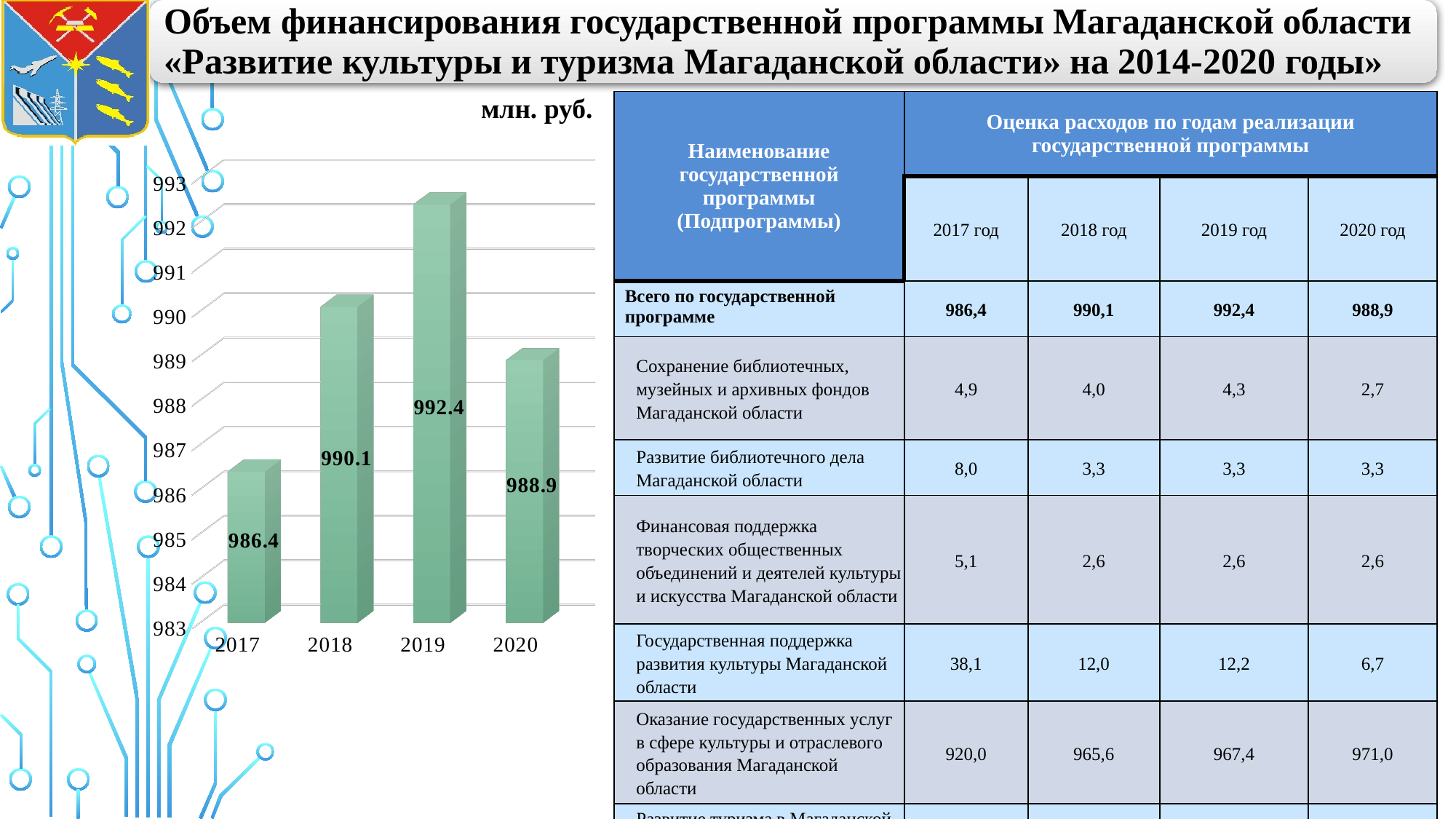
What is the value for 2020 in the bar chart? 988.9 Which is larger in the bar chart, the value for 2018 or the value for 2020? 2018 What unit is indicated above the bar chart? млн. руб. Which year has the lowest value in the bar chart? 2017 Which year has the highest value in the bar chart? 2019 How many years are shown in the bar chart? 4 What is the value for 2019 in the bar chart? 992.4 What is the value for 2017 in the bar chart? 986.4 What is the difference between the values for 2019 and 2017 in the bar chart? 6.0 What is the difference between the values for 2018 and 2020 in the bar chart? 1.2 What kind of chart is shown on the slide? bar chart Is the value for 2018 in the bar chart greater or less than 990? greater